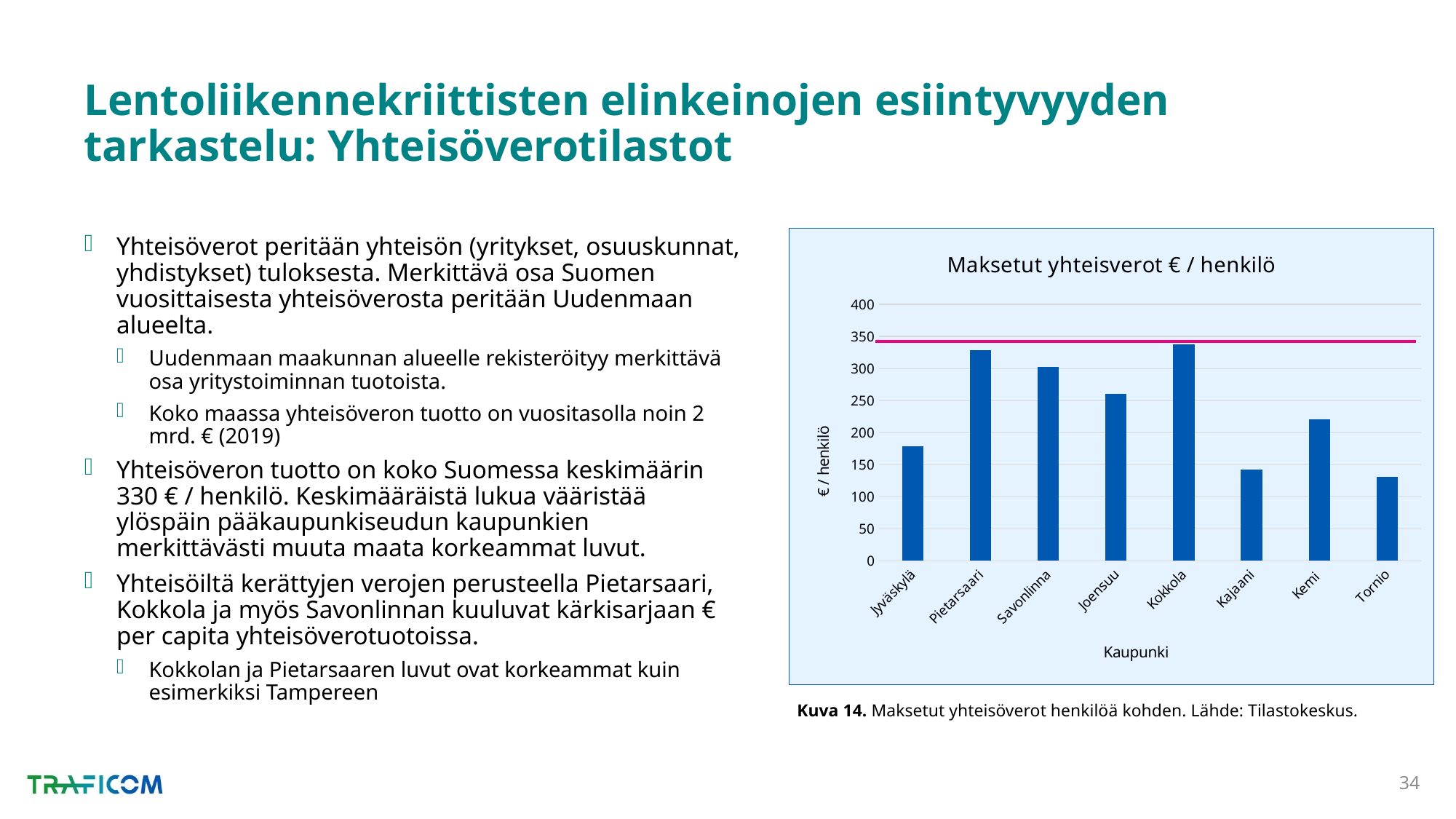
Is the value for Joensuu greater or less than 300? less What is the title of the chart? Maksetut yhteisverot € / henkilö Is the value for Pietarsaari greater or less than 300? greater Is the value for Jyväskylä greater or less than 200? less What is the label of the x axis of the chart? Kaupunki Which has a higher value, Kemi or Kajaani? Kemi Which has a higher value, Jyväskylä or Joensuu? Joensuu How many cities are shown on the x axis of the chart? 8 What kind of chart is shown on the slide? Bar chart